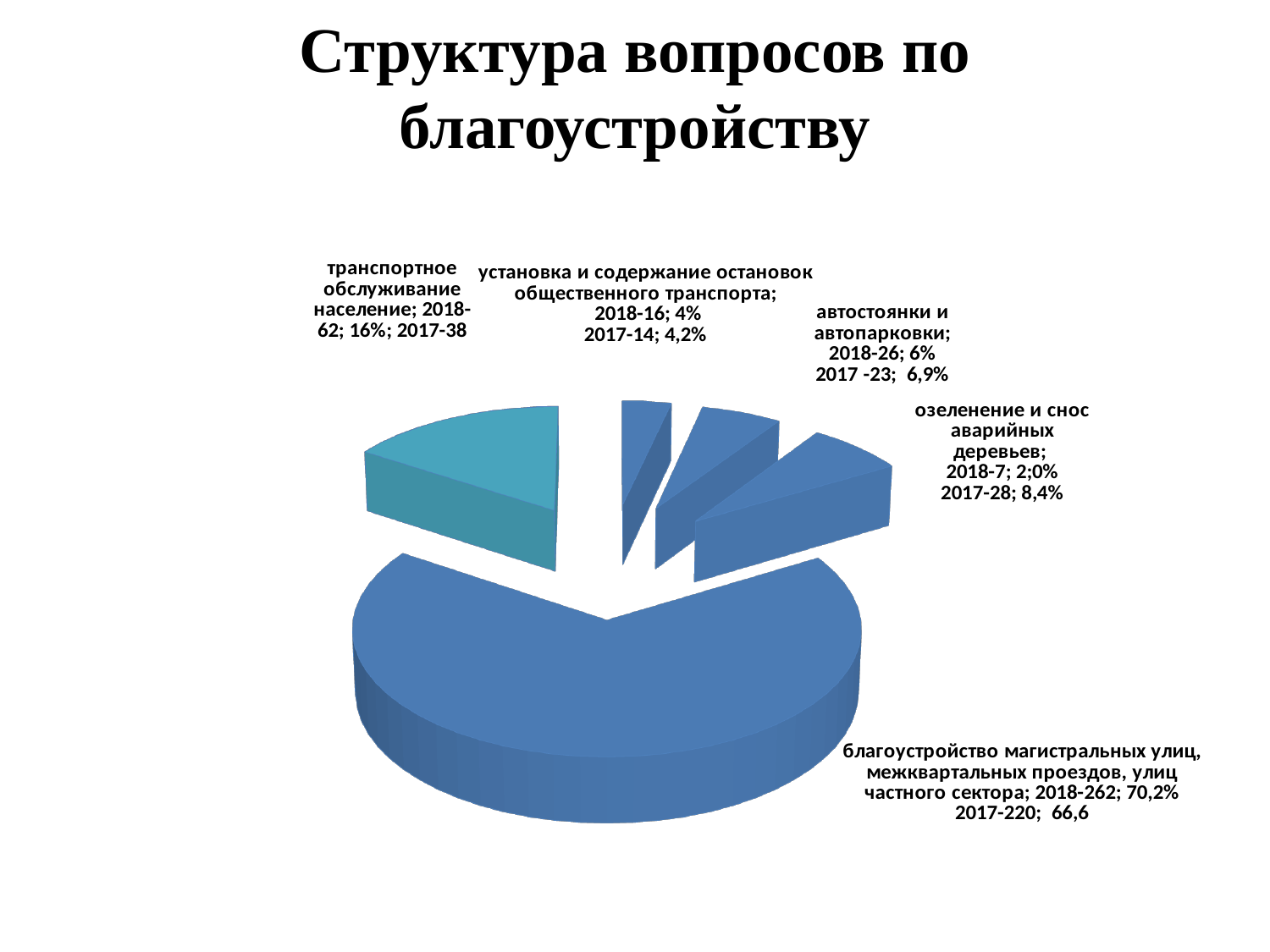
Which category has the smallest 2018 value? озеленение и снос аварийных деревьев What share of the pie does "благоустройство магистральных улиц, межквартальных проездов, улиц частного сектора" have in 2018? 70,2% What percentage share is shown for "установка и содержание остановок общественного транспорта" in 2017? 4,2% What is the 2017 value for "озеленение и снос аварийных деревьев"? 28 What is the 2017 value for "автостоянки и автопарковки"? 23 Which category has the largest slice of the pie? благоустройство магистральных улиц, межквартальных проездов, улиц частного сектора Which is larger in 2018: "автостоянки и автопарковки" or "установка и содержание остановок общественного транспорта"? автостоянки и автопарковки What is the 2018 value for "транспортное обслуживание население"? 62 What kind of chart is shown on the slide? pie chart What is the title of the chart on the slide? Структура вопросов по благоустройству How many slices does the pie chart have? 5 What is the difference between the 2018 and 2017 values for "благоустройство магистральных улиц, межквартальных проездов, улиц частного сектора"? 42